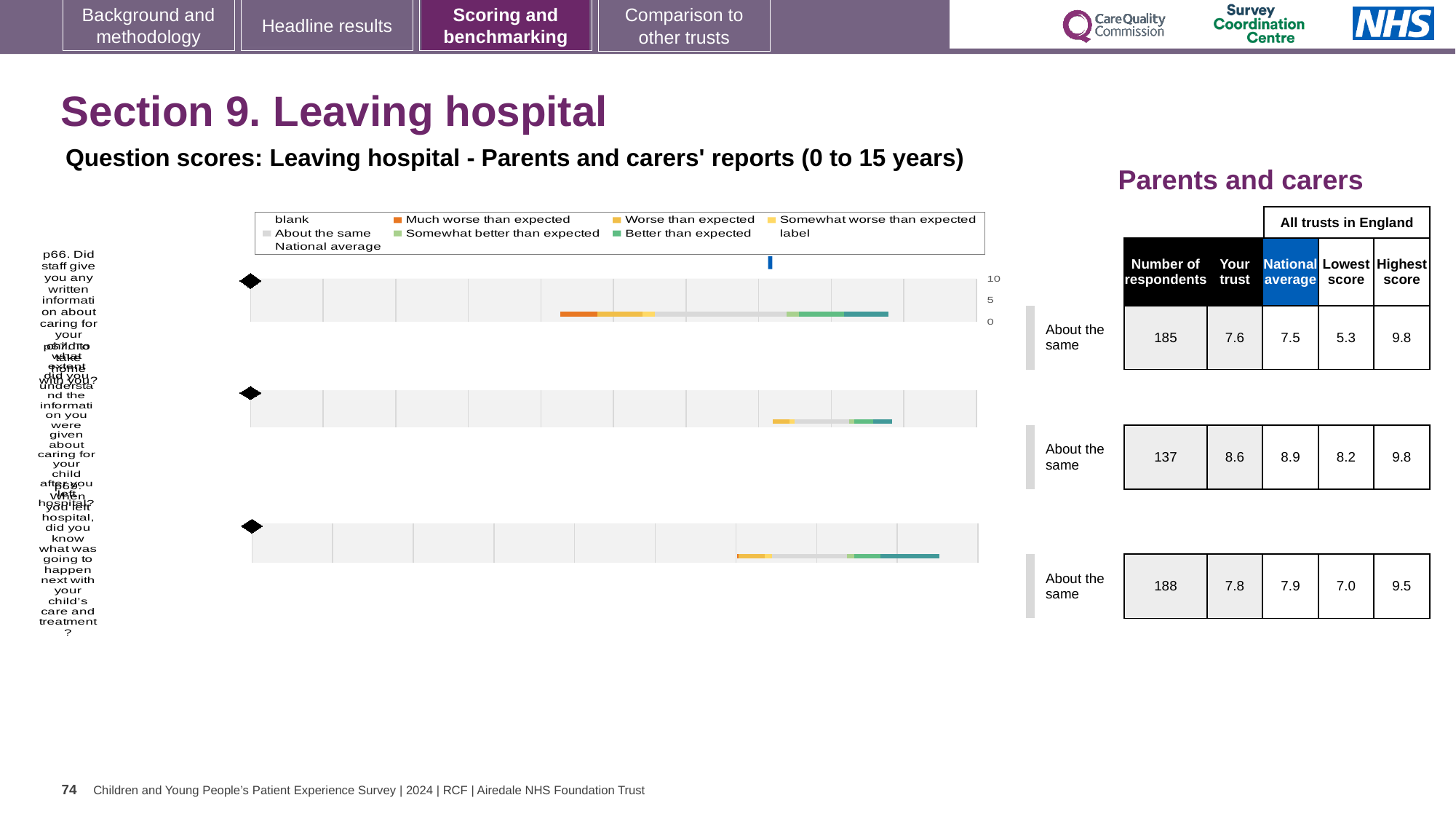
In the table on the right, what is the number of respondents for the first question row? 185 In the table on the right, what is the 'Your trust' score for the second question row? 8.6 In the table on the right, for the first question row, is the 'Your trust' score or the national average larger? Your trust (7.6) In the table on the right, what is the lowest score for the first question row? 5.3 In the table on the right, what is the difference between the national average and the 'Your trust' score for the second question row? 0.3 In the table on the right, what is the highest score for the third question row? 9.5 How many question rows (bar charts) are plotted on the slide? 3 In the table on the right, which question row has the highest number of respondents? the third row (188) In the table on the right, what is the national average for the third question row? 7.9 What is the highest tick value shown on the chart axis? 10 Which legend entry is shown in orange? Much worse than expected What kind of chart is used to show the question scores on this slide? bar chart